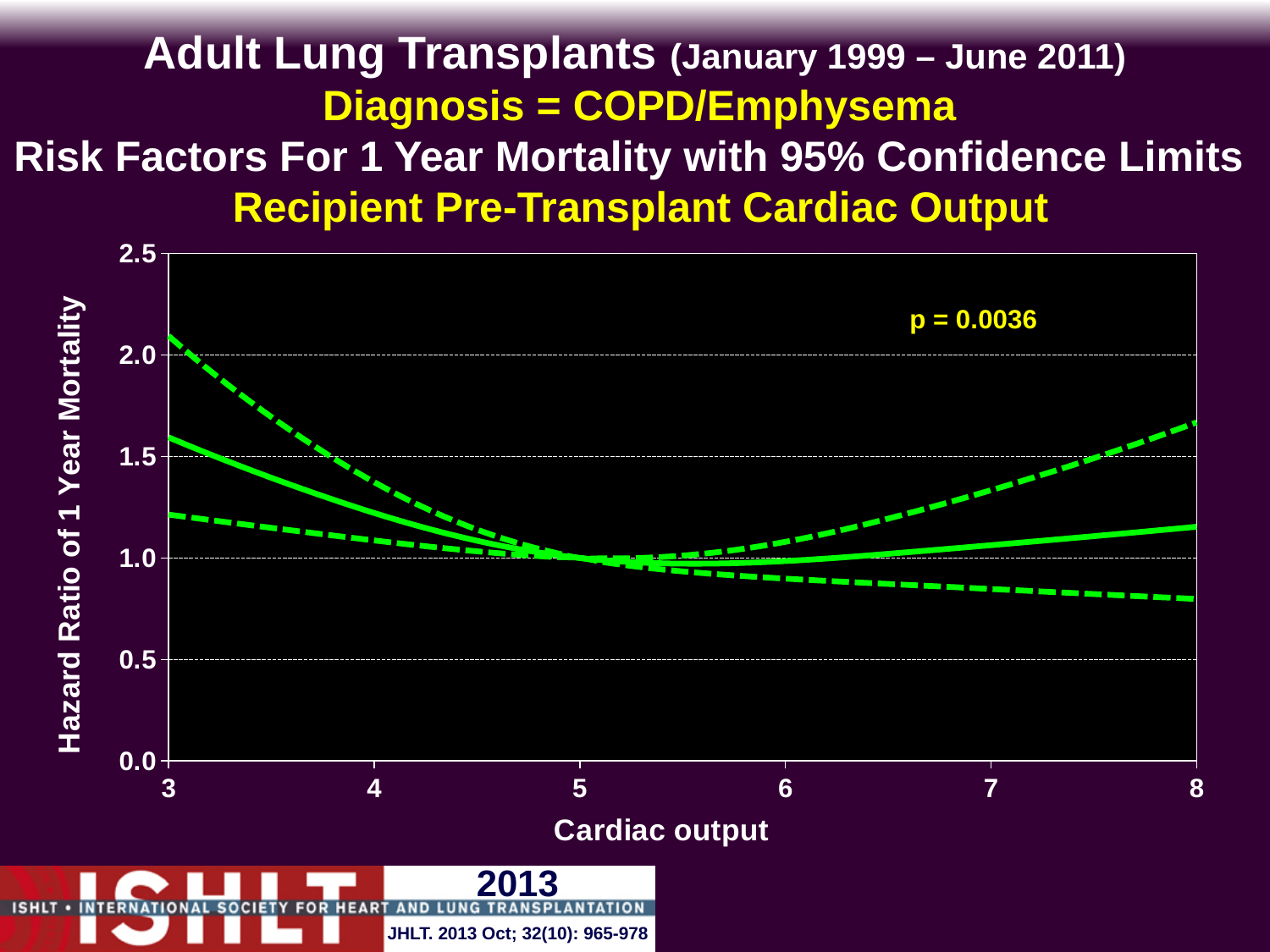
How many lines are plotted on the chart? 3 Is the value of the solid line at a cardiac output of 3 greater or less than 1.0? greater Is the value of the upper dashed confidence limit at a cardiac output of 8 greater or less than 1.5? greater What kind of chart is shown on the slide? line chart Is the value of the upper dashed confidence limit at a cardiac output of 3 greater or less than 1.5? greater Does the lower dashed confidence limit rise or fall as cardiac output increases from 3 to 8? fall What is the p-value printed on the chart? p = 0.0036 What is the label of the y axis? Hazard Ratio of 1 Year Mortality How many tick values are labelled on the x axis? 6 Does the solid hazard ratio line rise or fall as cardiac output increases from 3 to 5? fall